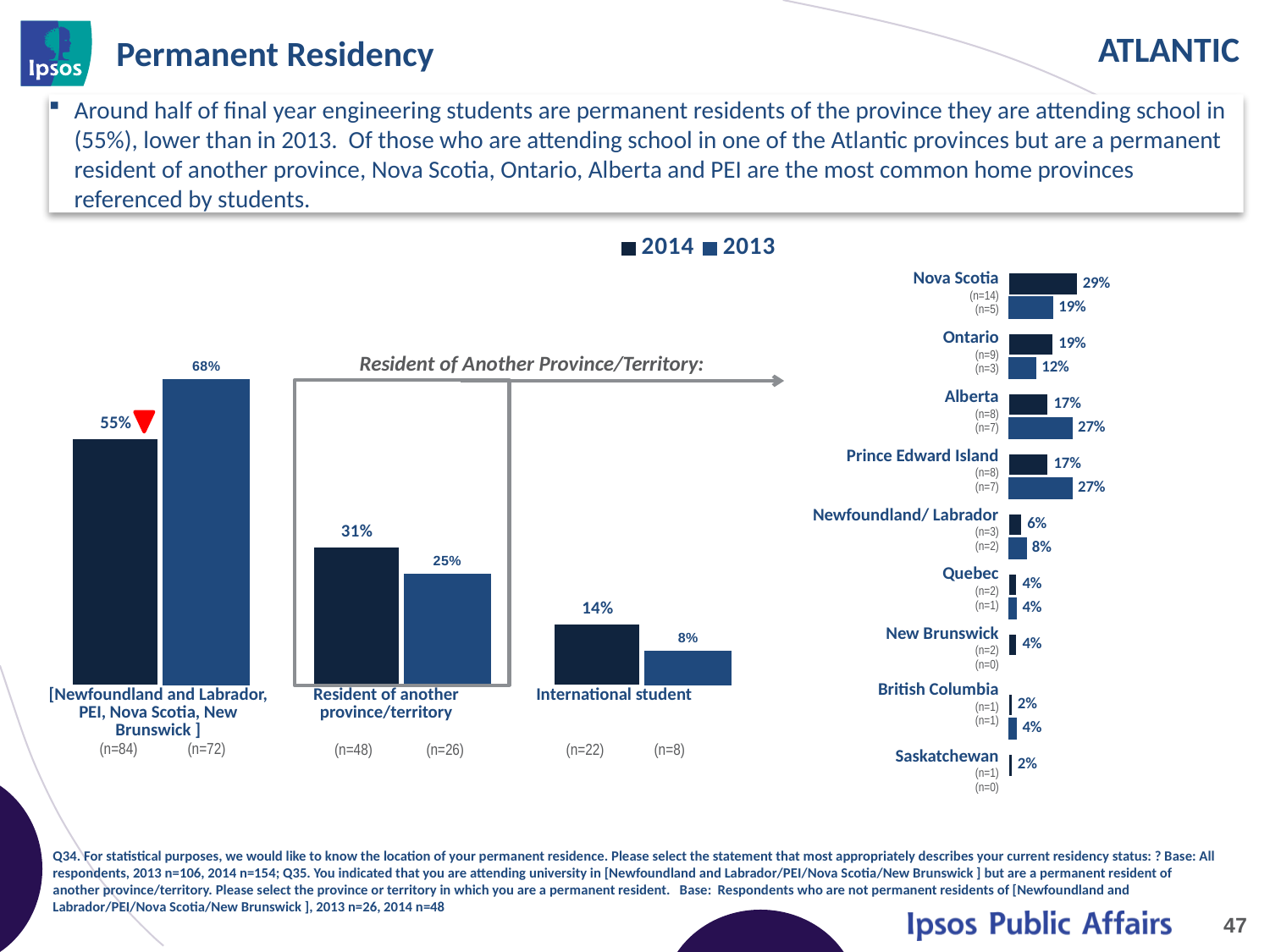
In the left chart, what is the 2013 value for 'International student'? 8% In the right chart (Resident of Another Province/Territory), what is the 2013 value for Alberta? 27% What type of chart is the right chart (Resident of Another Province/Territory)? bar chart In the left chart, is the 2014 value for 'International student' larger or smaller than the 2013 value? larger How many series does the legend list? 2 In the right chart (Resident of Another Province/Territory), which province has the highest 2014 value? Nova Scotia In the left chart, what is the difference between the 2013 and 2014 values for '[Newfoundland and Labrador, PEI, Nova Scotia, New Brunswick]'? 13% In the right chart (Resident of Another Province/Territory), what is the difference between the 2014 and 2013 values for Ontario? 7% In the left chart, which category has the highest 2014 value? [Newfoundland and Labrador, PEI, Nova Scotia, New Brunswick] In the right chart (Resident of Another Province/Territory), what is the 2014 value for Nova Scotia? 29% In the left chart, what is the 2014 value for 'Resident of another province/territory'? 31% In the right chart (Resident of Another Province/Territory), how many provinces/territories are listed? 9